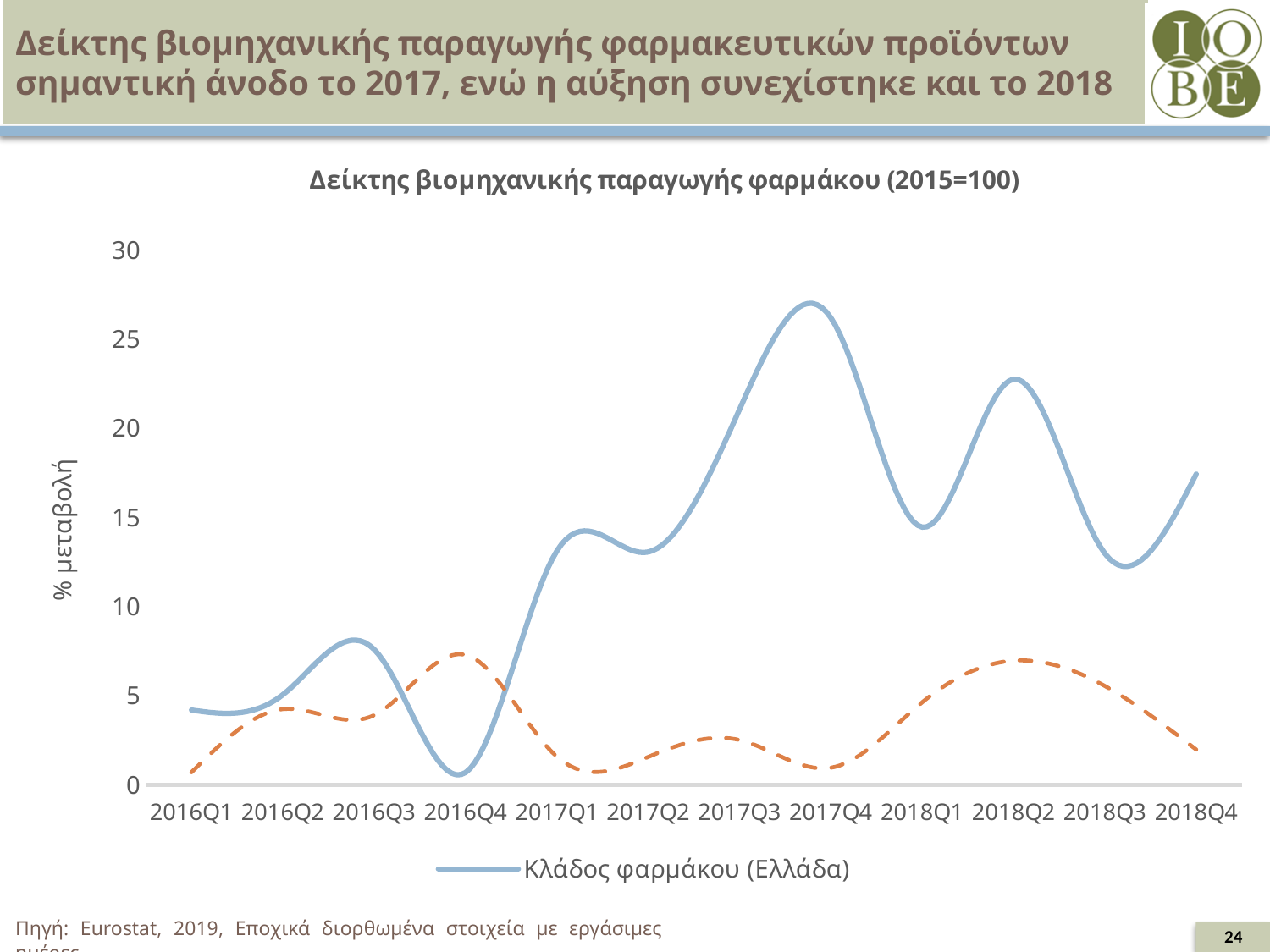
In which quarter does the solid line 'Κλάδος φαρμάκου (Ελλάδα)' reach its lowest value? 2016Q4 Is the value of 'Κλάδος φαρμάκου (Ελλάδα)' in 2016Q3 greater or less than 5? greater Overall, does the 'Κλάδος φαρμάκου (Ελλάδα)' line rise or fall from 2016Q1 to 2018Q4? rise How many series does the chart's legend list? 1 How many quarters are shown on the x axis of the chart? 12 Which is larger for 'Κλάδος φαρμάκου (Ελλάδα)': the value in 2016Q3 or the value in 2018Q2? 2018Q2 What is the title of the chart? Δείκτης βιομηχανικής παραγωγής φαρμάκου (2015=100) What is the label of the y axis? % μεταβολή Is the value of 'Κλάδος φαρμάκου (Ελλάδα)' in 2016Q4 greater or less than 5? less What kind of chart is shown on the slide? line chart Is the value of 'Κλάδος φαρμάκου (Ελλάδα)' in 2018Q2 greater or less than 20? greater